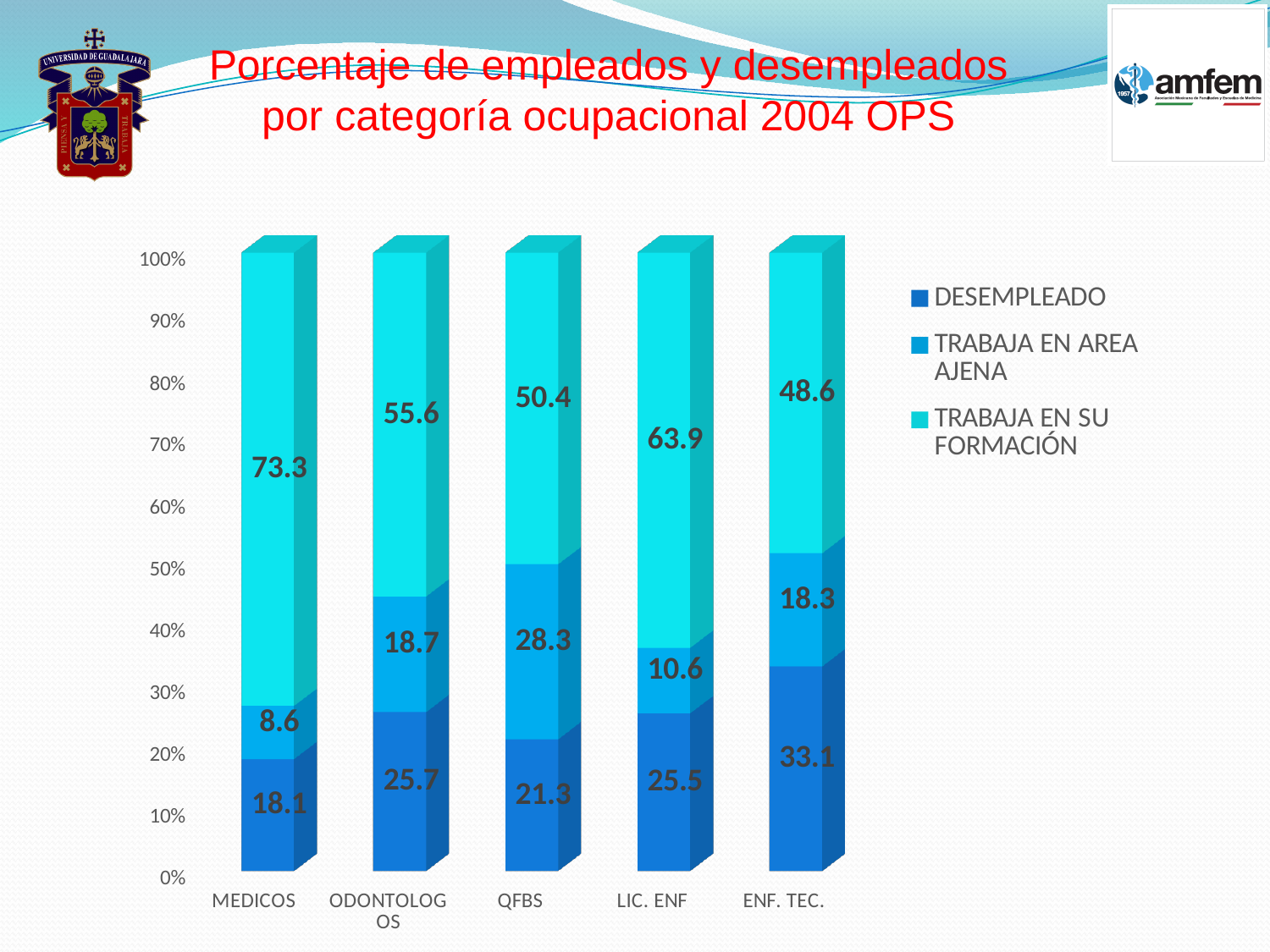
What is the TRABAJA EN AREA AJENA value for QFBS? 28.3 How many categories are shown on the x axis? 5 How many series does the legend list? 3 Which category has the lowest TRABAJA EN AREA AJENA value? MEDICOS What kind of chart is shown on the slide? Stacked bar chart What is the difference between the TRABAJA EN SU FORMACIÓN values for MEDICOS and ENF. TEC.? 24.7 Which is larger, the DESEMPLEADO value for ODONTOLOGOS or for QFBS? ODONTOLOGOS Which category has the highest DESEMPLEADO value? ENF. TEC. What is the DESEMPLEADO value for MEDICOS? 18.1 Which category has the highest TRABAJA EN SU FORMACIÓN value? MEDICOS What is the TRABAJA EN SU FORMACIÓN value for LIC. ENF? 63.9 What is the DESEMPLEADO value for ENF. TEC.? 33.1